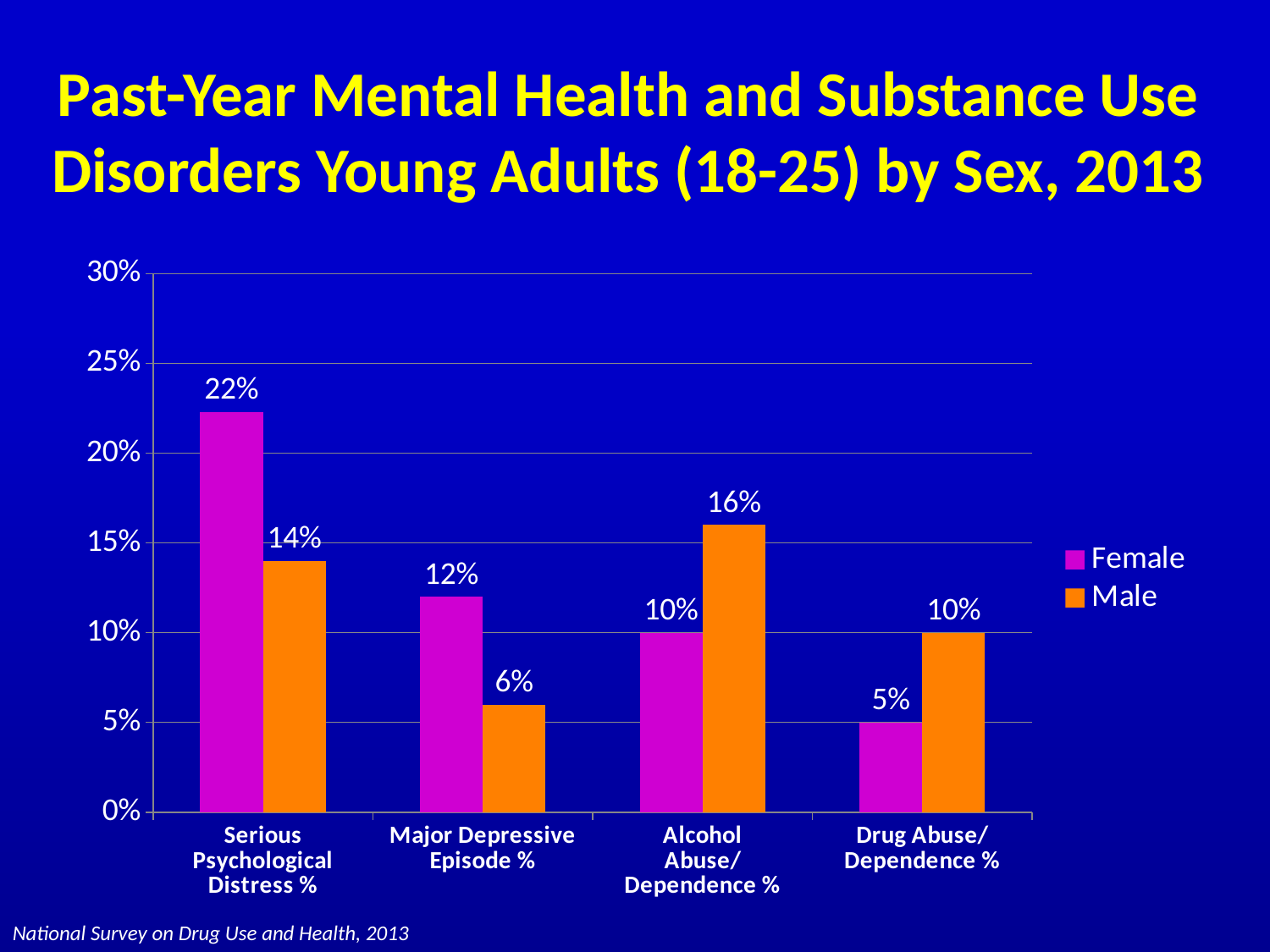
How many series does the legend list? 2 Which category has the highest Female value? Serious Psychological Distress % Which is larger for Alcohol Abuse/Dependence %, the Female value or the Male value? Male What is the Male value for Major Depressive Episode %? 6% What colour are the Male bars? Orange How many categories are shown on the x axis? 4 What is the difference between the Female and Male values for Serious Psychological Distress %? 8% What is the Female value for Drug Abuse/Dependence %? 5% What kind of chart is shown on the slide? Bar chart Which category has the lowest Male value? Major Depressive Episode % What is the Male value for Alcohol Abuse/Dependence %? 16% What is the Female value for Serious Psychological Distress %? 22%